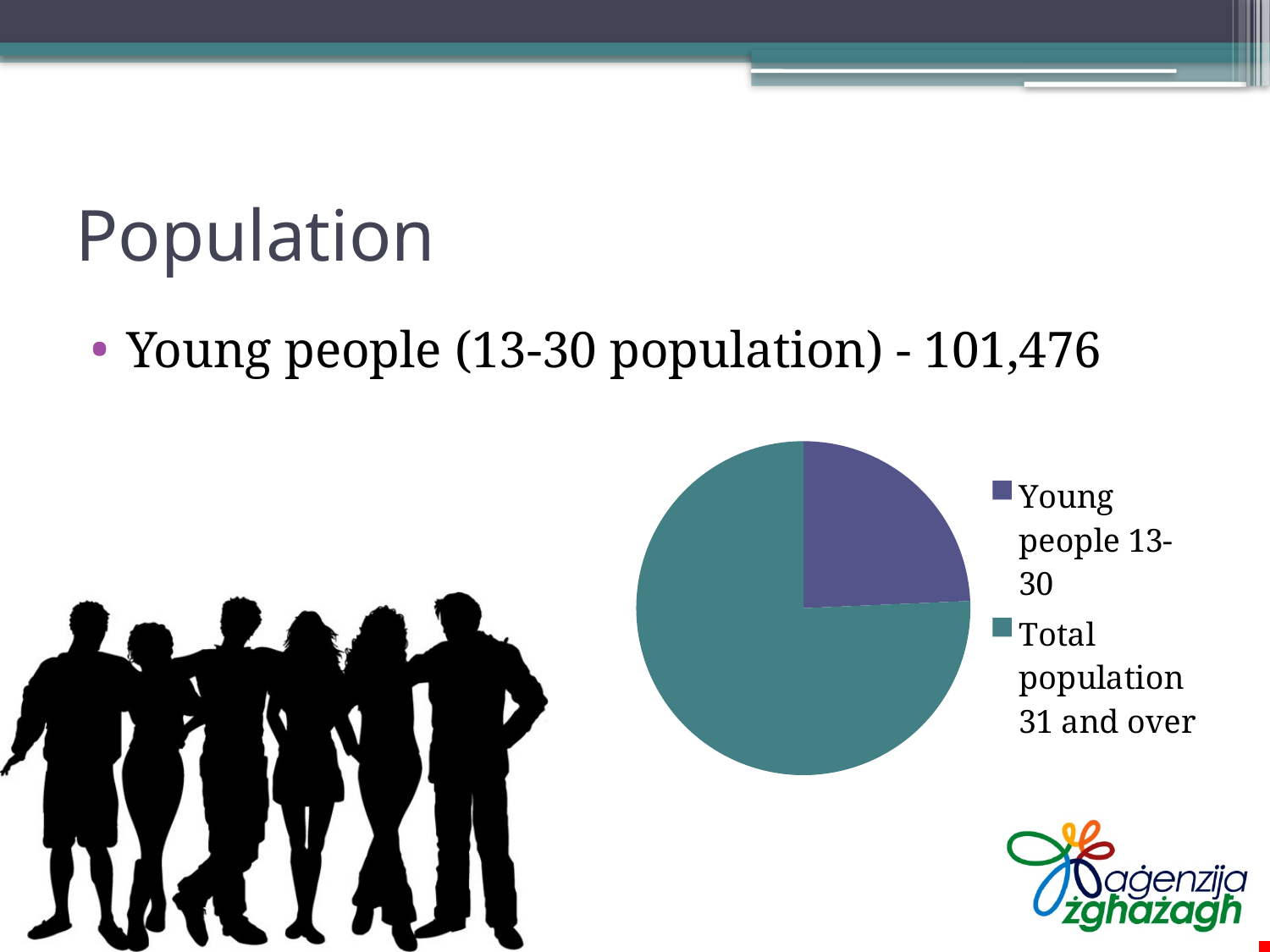
What colour is the Young people 13-30 slice in the pie chart? purple Is the Total population 31 and over slice greater or less than half of the pie? greater What kind of chart is shown on the slide? pie chart Which slice of the pie chart is the largest? Total population 31 and over How many entries does the legend of the pie chart list? 2 Which is larger in the pie chart, the Young people 13-30 slice or the Total population 31 and over slice? Total population 31 and over What colour is the Total population 31 and over slice in the pie chart? teal Is the Young people 13-30 slice greater or less than half of the pie? less Which slice of the pie chart is the smallest? Young people 13-30 How many slices does the pie chart have? 2